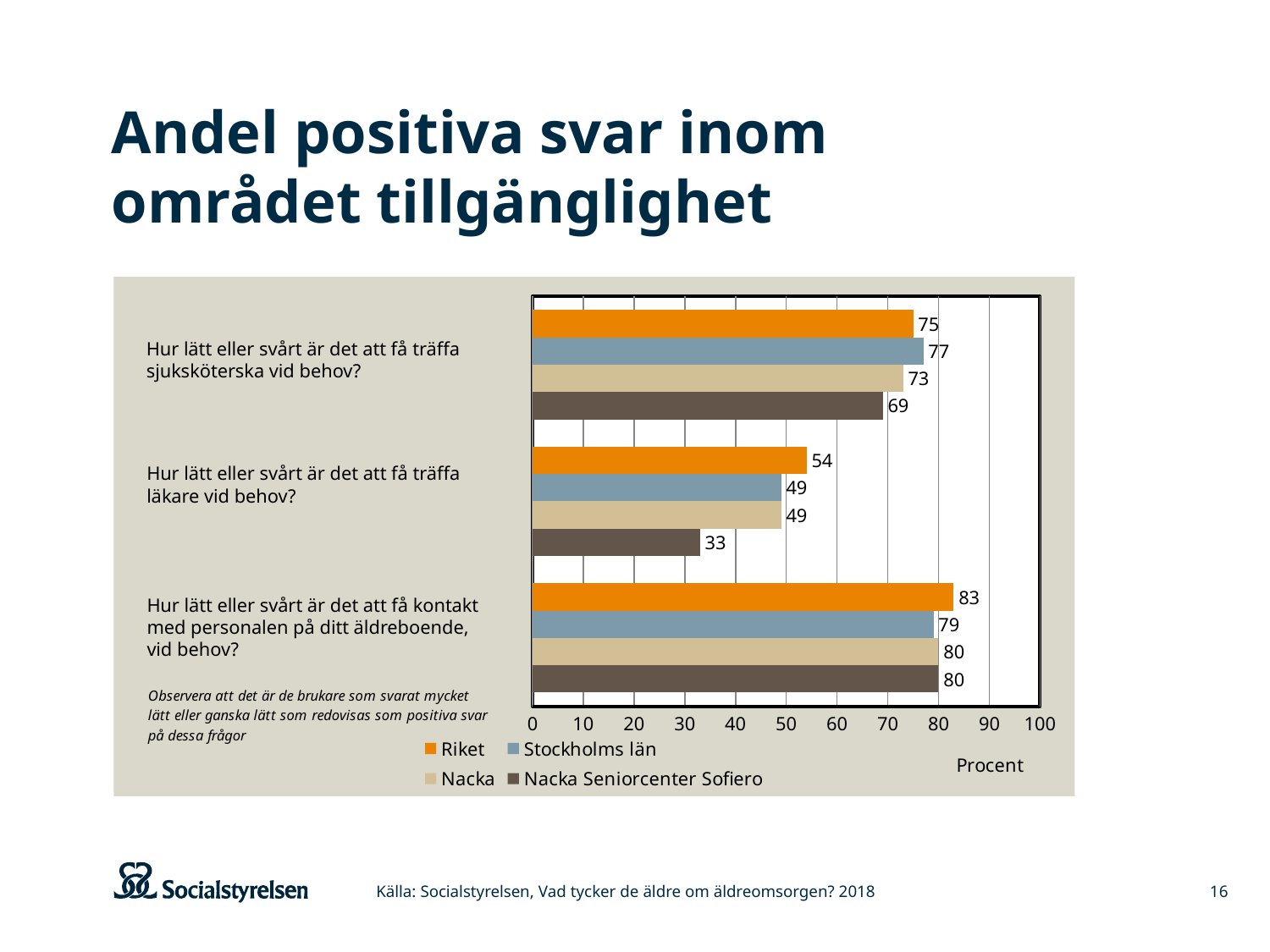
How many series does the legend list? 4 What is the value for Stockholms län on the question "Hur lätt eller svårt är det att få kontakt med personalen på ditt äldreboende, vid behov?"? 79 Which series has the highest value on the question "Hur lätt eller svårt är det att få kontakt med personalen på ditt äldreboende, vid behov?"? Riket How many questions (categories) are shown in the chart? 3 What is the value for Riket on the question "Hur lätt eller svårt är det att få träffa sjuksköterska vid behov?"? 75 Is the value for Nacka Seniorcenter Sofiero on the question "Hur lätt eller svårt är det att få träffa läkare vid behov?" greater or less than 40? less What kind of chart is shown on the slide? Bar chart What is the label of the x axis? Procent Which series has the lowest value on the question "Hur lätt eller svårt är det att få träffa sjuksköterska vid behov?"? Nacka Seniorcenter Sofiero Which is larger on the question "Hur lätt eller svårt är det att få träffa sjuksköterska vid behov?": Stockholms län or Nacka? Stockholms län What is the difference between Riket and Nacka Seniorcenter Sofiero on the question "Hur lätt eller svårt är det att få träffa läkare vid behov?"? 21 What is the value for Nacka Seniorcenter Sofiero on the question "Hur lätt eller svårt är det att få träffa läkare vid behov?"? 33